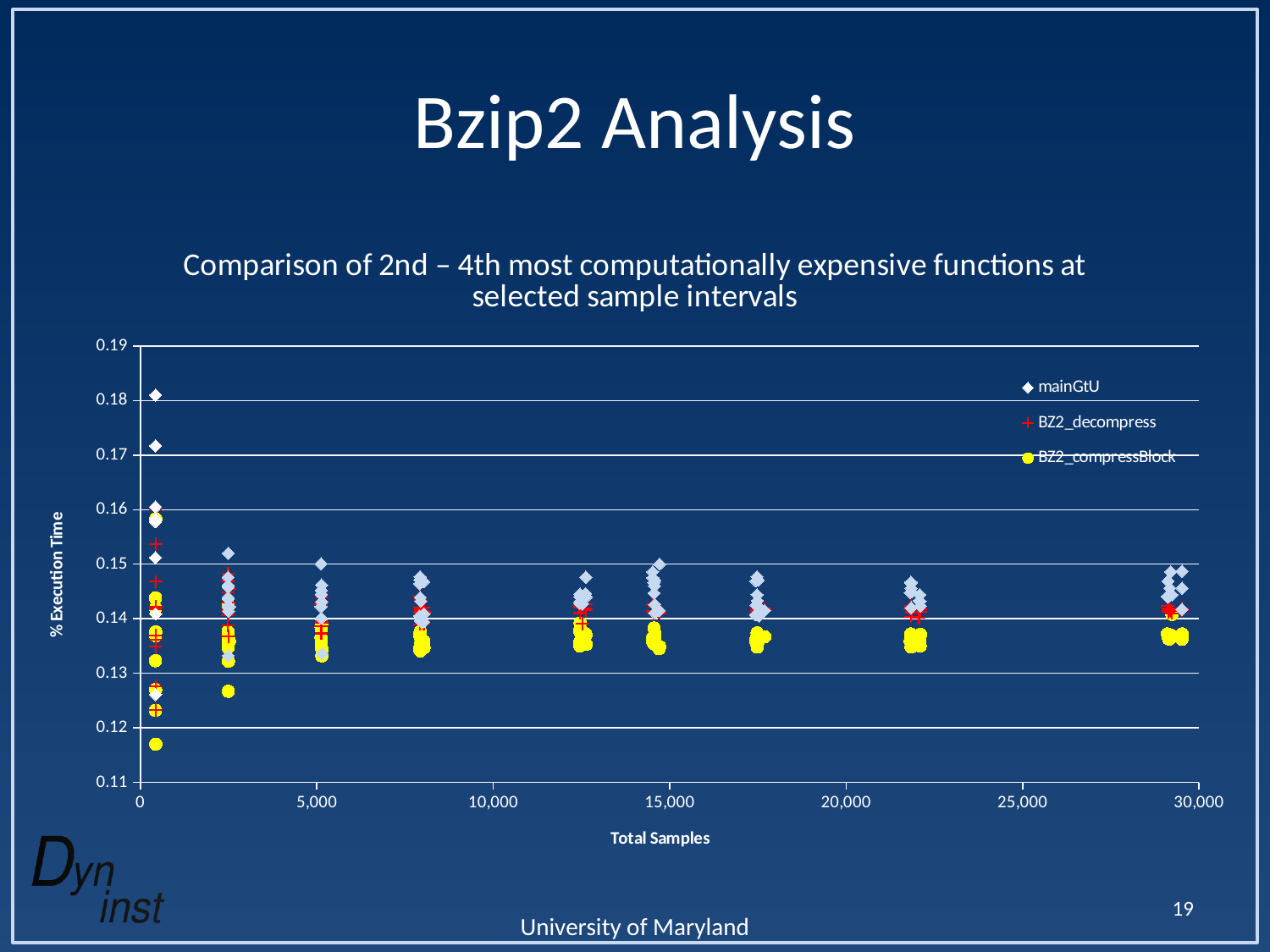
What kind of chart is shown on the slide? Scatter chart Is the lowest BZ2_compressBlock value near 0 Total Samples greater or less than 0.12? less Near 30,000 Total Samples, which series has the higher values, mainGtU or BZ2_compressBlock? mainGtU How many series does the chart legend list? 3 As Total Samples increase, does the spread of the plotted values become wider or narrower? narrower Is the highest mainGtU value near 0 Total Samples greater or less than 0.17? greater Are the mainGtU values near 30,000 Total Samples greater or less than 0.14? greater Which series is plotted with yellow circle markers? BZ2_compressBlock What is the title of the vertical axis? % Execution Time Which series reaches the highest % Execution Time anywhere on the chart? mainGtU Which series has the lowest % Execution Time anywhere on the chart? BZ2_compressBlock